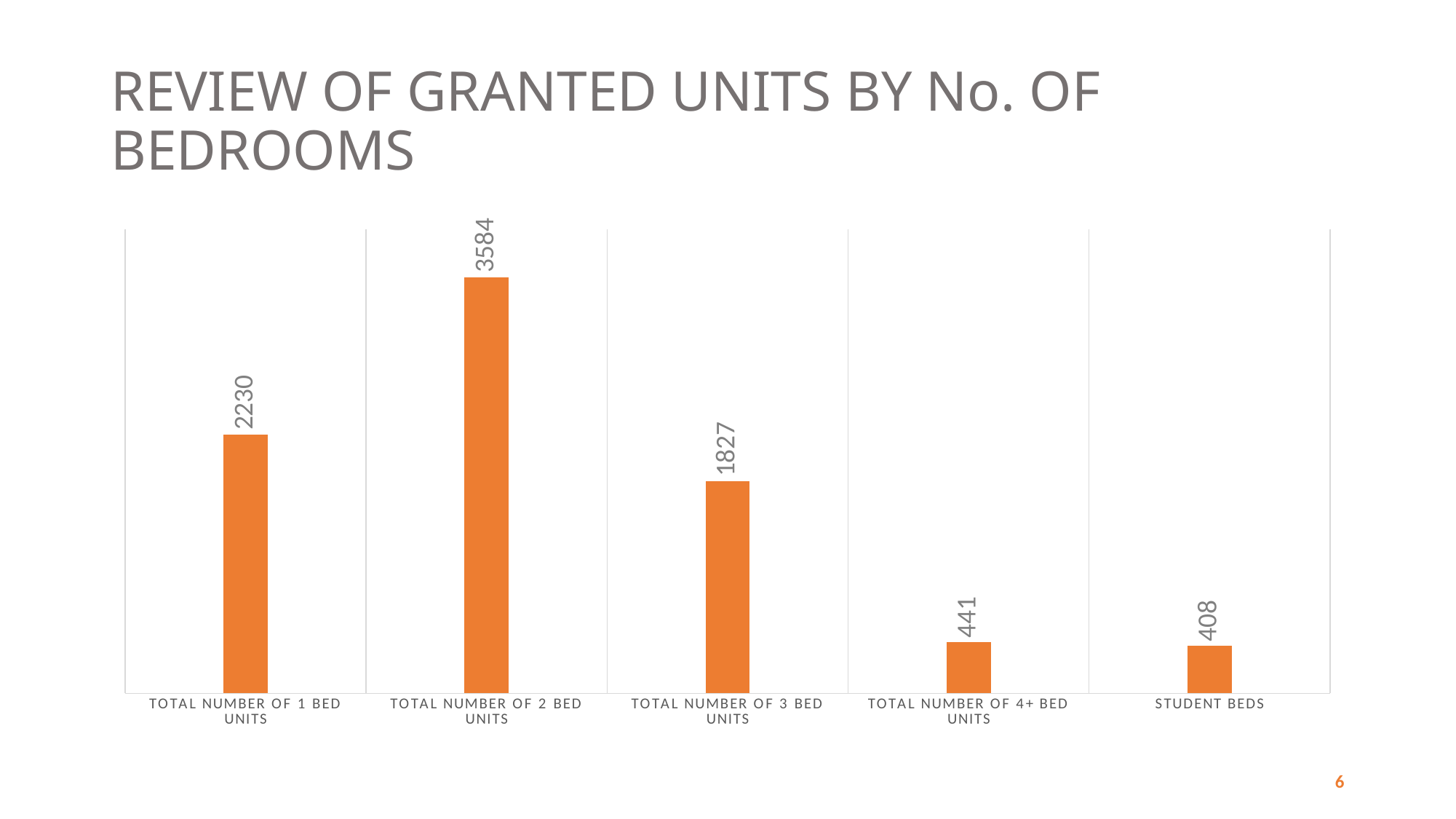
What is the total number of 3 bed units? 1827 How many categories are shown in the chart? 5 What is the total number of 1 bed units? 2230 What is the total number of 2 bed units? 3584 What is the value for Student Beds? 408 What kind of chart is shown on the slide? Bar chart Which category has the highest value? Total number of 2 bed units What is the total number of 4+ bed units? 441 Which is larger: the total number of 1 bed units or the total number of 3 bed units? Total number of 1 bed units Which category has the lowest value? Student beds What is the difference between the total number of 4+ bed units and Student Beds? 33 What is the difference between the total number of 2 bed units and the total number of 1 bed units? 1354